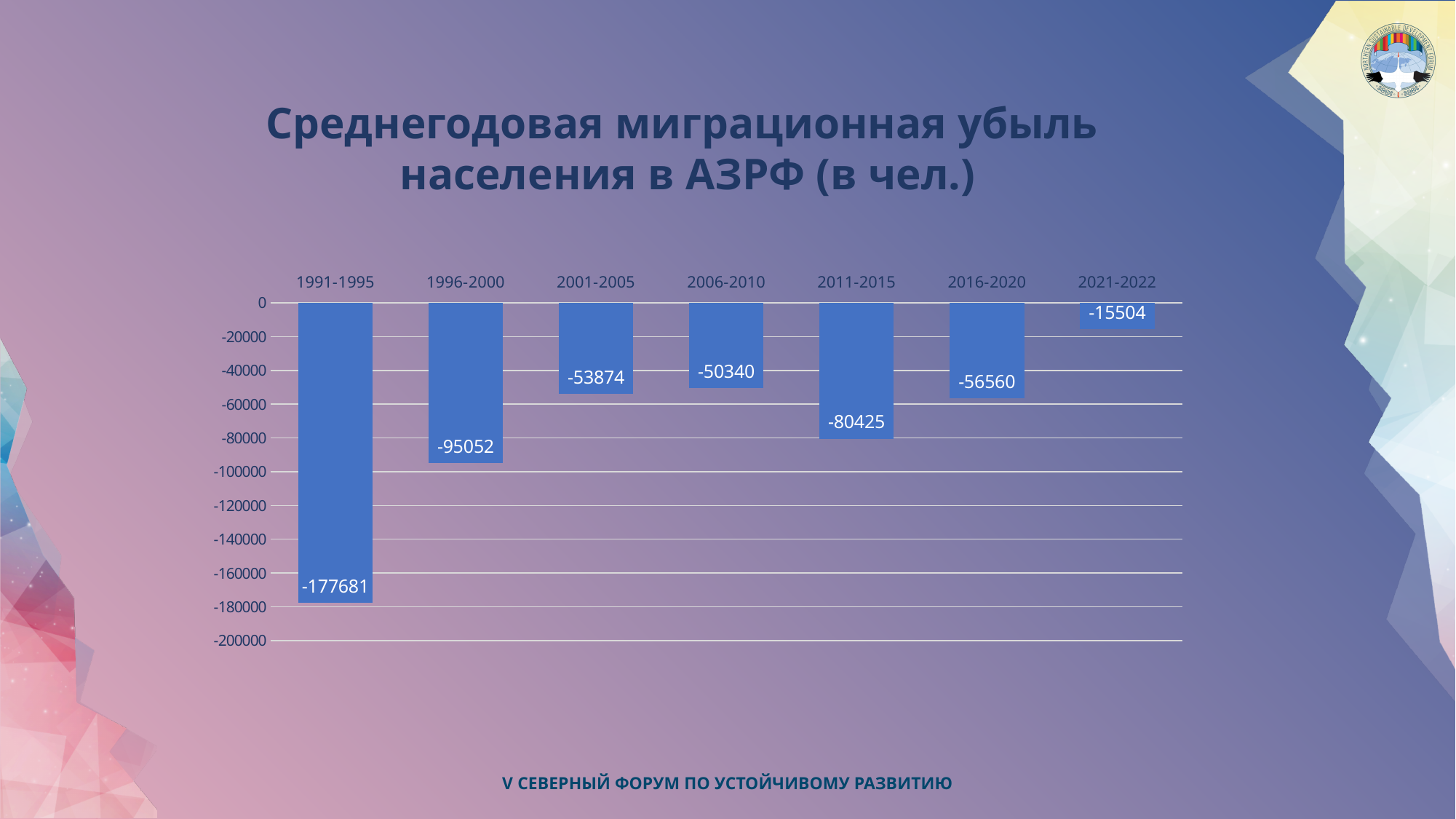
Which period has the highest value (closest to zero)? 2021-2022 Which value is larger, 2006-2010 or 2016-2020? 2006-2010 How many periods are shown on the x axis? 7 What is the difference between the values for 2011-2015 and 2021-2022? 64921 Which period has the lowest (most negative) value? 1991-1995 What is the value for 1991-1995? -177681 What is the value for 2021-2022? -15504 Is the value for 1991-1995 greater or less than -160000? less What kind of chart is shown on the slide? bar chart What is the difference between the values for 1996-2000 and 2001-2005? 41178 What is the value for 2011-2015? -80425 What is the title of the chart? Среднегодовая миграционная убыль населения в АЗРФ (в чел.)